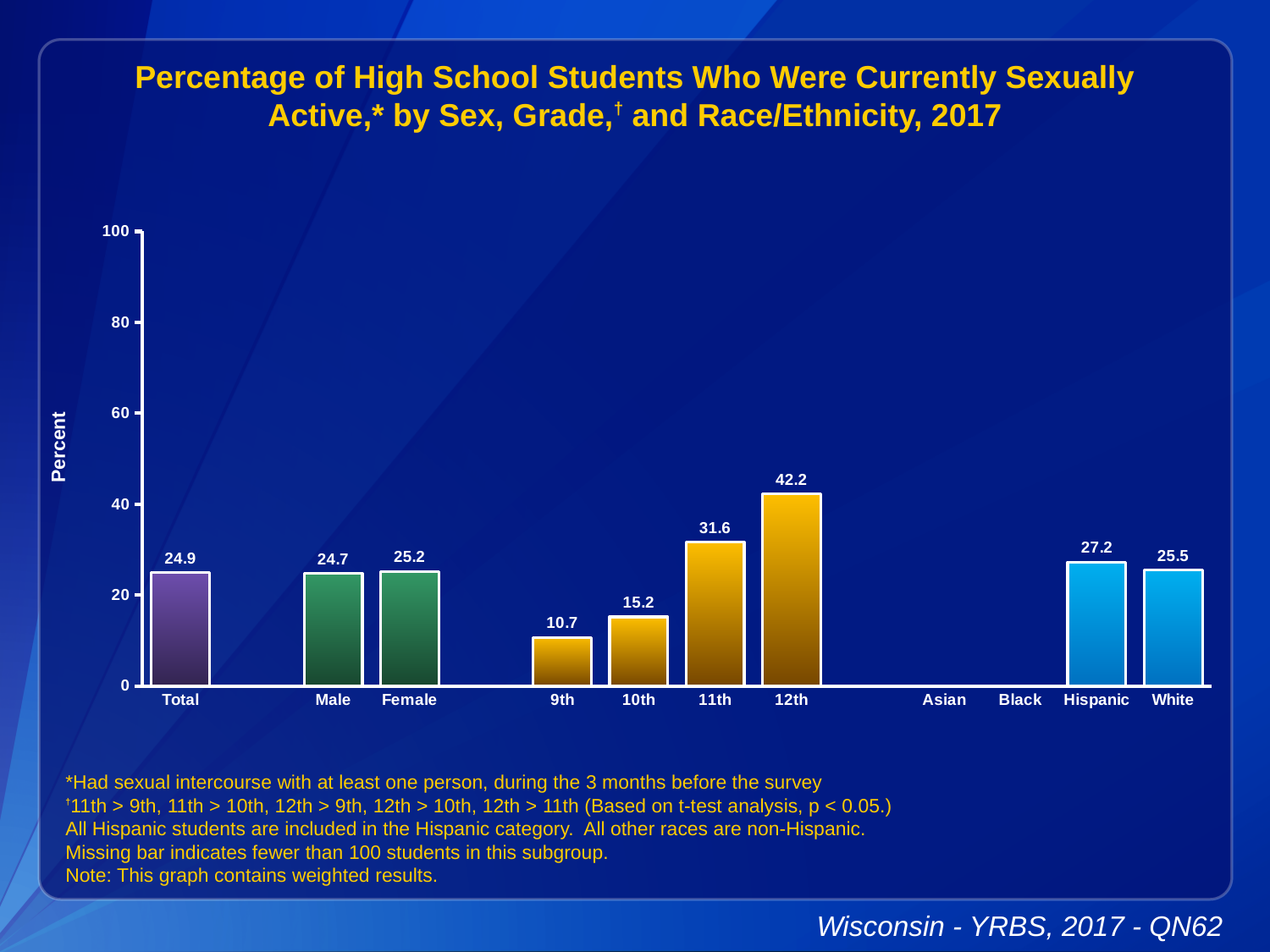
How many categories are labeled on the x axis? 11 What is the value for 12th grade students? 42.2 Which categories have no bar plotted? Asian and Black Which is larger, the value for Male or the value for Female? Female What kind of chart is shown? bar chart What is the value for Hispanic students? 27.2 Which category has the highest value? 12th Is the value for 11th grade students greater or less than 40? less Do the values rise or fall from 9th grade to 12th grade? rise Which category with a plotted bar has the lowest value? 9th What is the value for Female students? 25.2 What is the difference between the values for 12th and 9th grade students? 31.5